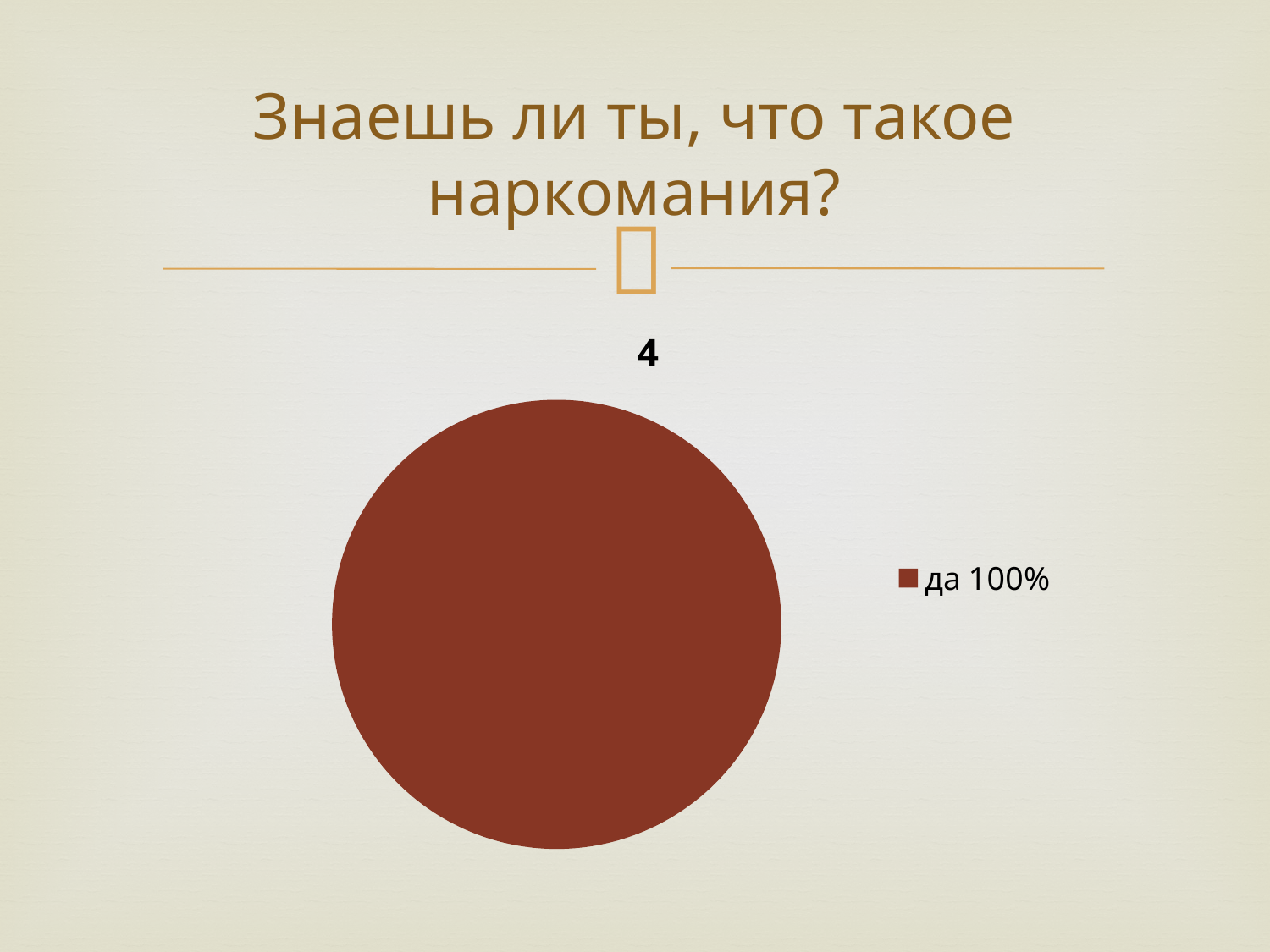
What share of the pie does the slice labelled "да" represent? 100% What kind of chart is shown on the slide? pie chart How many entries does the legend of the pie chart list? 1 What is the title of the pie chart? 4 What is the legend entry shown next to the pie chart? да 100% How many slices does the pie chart have? 1